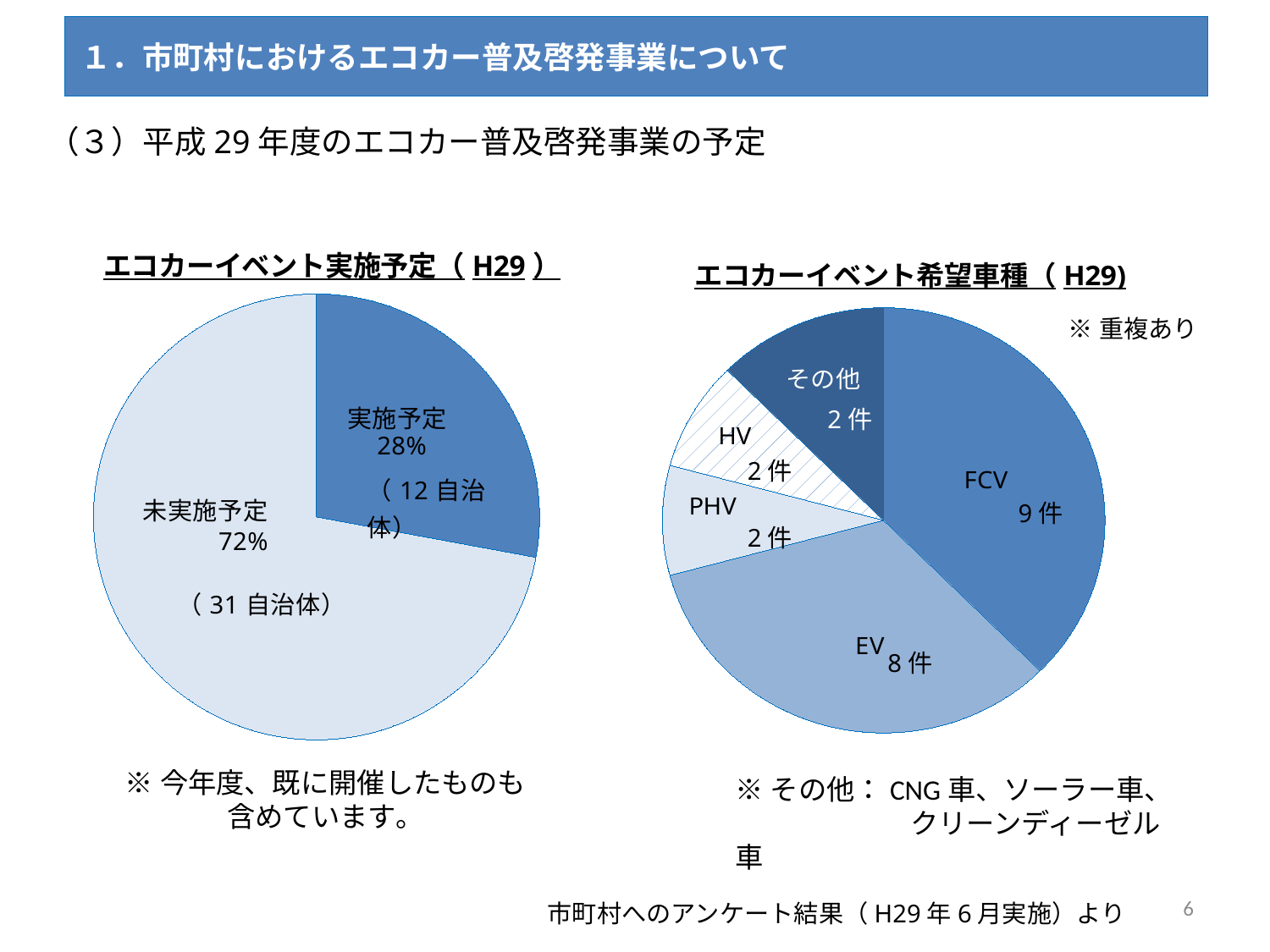
In the left chart エコカーイベント実施予定（H29）, what is the difference in percentage points between 未実施予定 and 実施予定? 44 In the right chart エコカーイベント希望車種（H29）, which vehicle type has the highest number of 件? FCV In the right chart エコカーイベント希望車種（H29）, how many categories are shown? 5 In the left chart エコカーイベント実施予定（H29）, how many 自治体 are in the 未実施予定 slice? 31 自治体 In the left chart エコカーイベント実施予定（H29）, what percentage is 実施予定? 28% In the right chart エコカーイベント希望車種（H29）, what is the total number of 件 across all slices? 23 What type of chart is the left chart エコカーイベント実施予定（H29）? Pie chart In the left chart エコカーイベント実施予定（H29）, which slice is larger, 実施予定 or 未実施予定? 未実施予定 In the right chart エコカーイベント希望車種（H29）, how many 件 does FCV have? 9 件 In the left chart エコカーイベント実施予定（H29）, what percentage is 未実施予定? 72% In the right chart エコカーイベント希望車種（H29）, what is the difference in 件 between FCV and PHV? 7 In the right chart エコカーイベント希望車種（H29）, how many 件 does EV have? 8 件